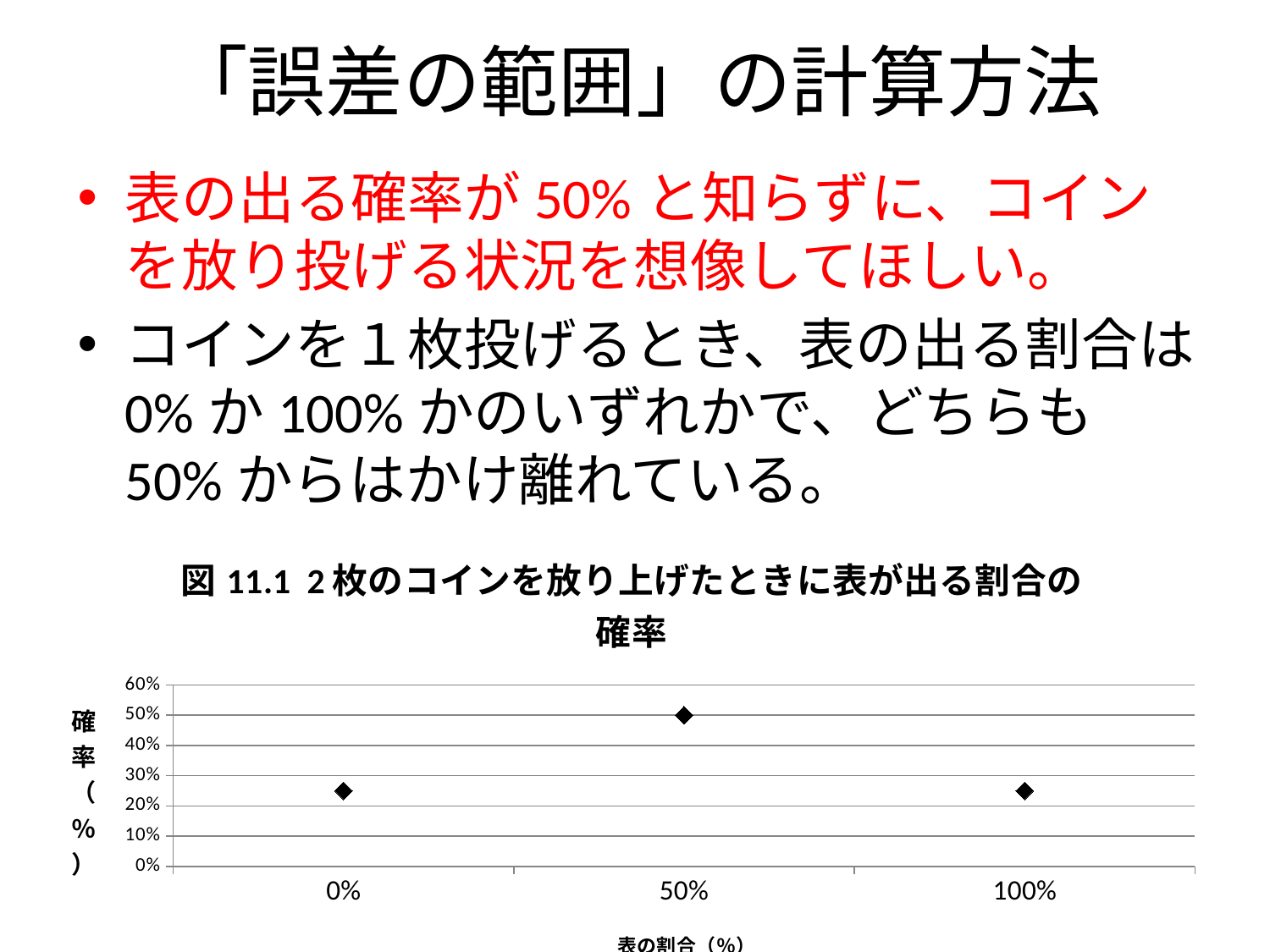
What is the probability value plotted for a heads proportion of 50%? 50% Is the plotted probability for a heads proportion of 0% greater or less than 30%? less How many data points are plotted in the chart? 3 Do the plotted probabilities rise or fall from a heads proportion of 50% to 100%? fall Is the plotted probability for a heads proportion of 0% greater or less than 20%? greater Is the plotted probability for a heads proportion of 100% greater or less than 20%? greater What is the title of the chart? 図 11.1 2枚のコインを放り上げたときに表が出る割合の確率 How many categories are shown on the x axis of the chart? 3 What is the label of the chart's vertical axis? 確率（%） Do the plotted probabilities rise or fall from a heads proportion of 0% to 50%? rise Which heads proportion on the x axis has the highest plotted probability? 50% Which has a larger plotted probability: a heads proportion of 50% or a heads proportion of 100%? 50%